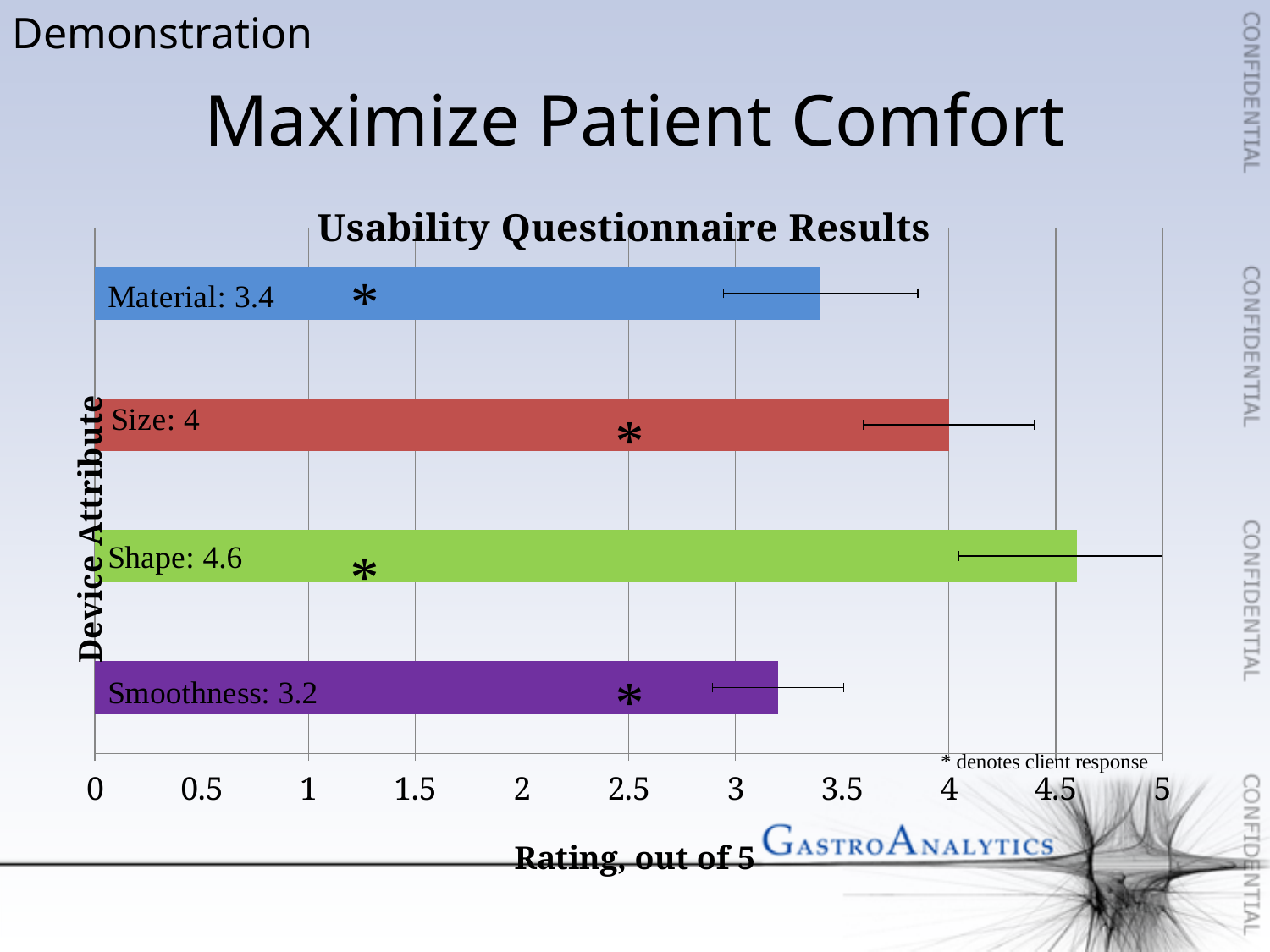
Which device attribute has the lowest rating in the Usability Questionnaire Results chart? Smoothness What is the rating for Size in the Usability Questionnaire Results chart? 4 What is the title of the x axis in the Usability Questionnaire Results chart? Rating, out of 5 What is the difference between the Shape rating and the Smoothness rating? 1.4 What is the rating for Material in the Usability Questionnaire Results chart? 3.4 How many device attributes are shown in the Usability Questionnaire Results chart? 4 Which device attribute has the highest rating in the Usability Questionnaire Results chart? Shape What kind of chart is the Usability Questionnaire Results chart? Bar chart Which has a higher rating, Size or Material? Size What is the rating for Smoothness in the Usability Questionnaire Results chart? 3.2 According to the note on the chart, what does the asterisk (*) denote? Client response What is the rating for Shape in the Usability Questionnaire Results chart? 4.6